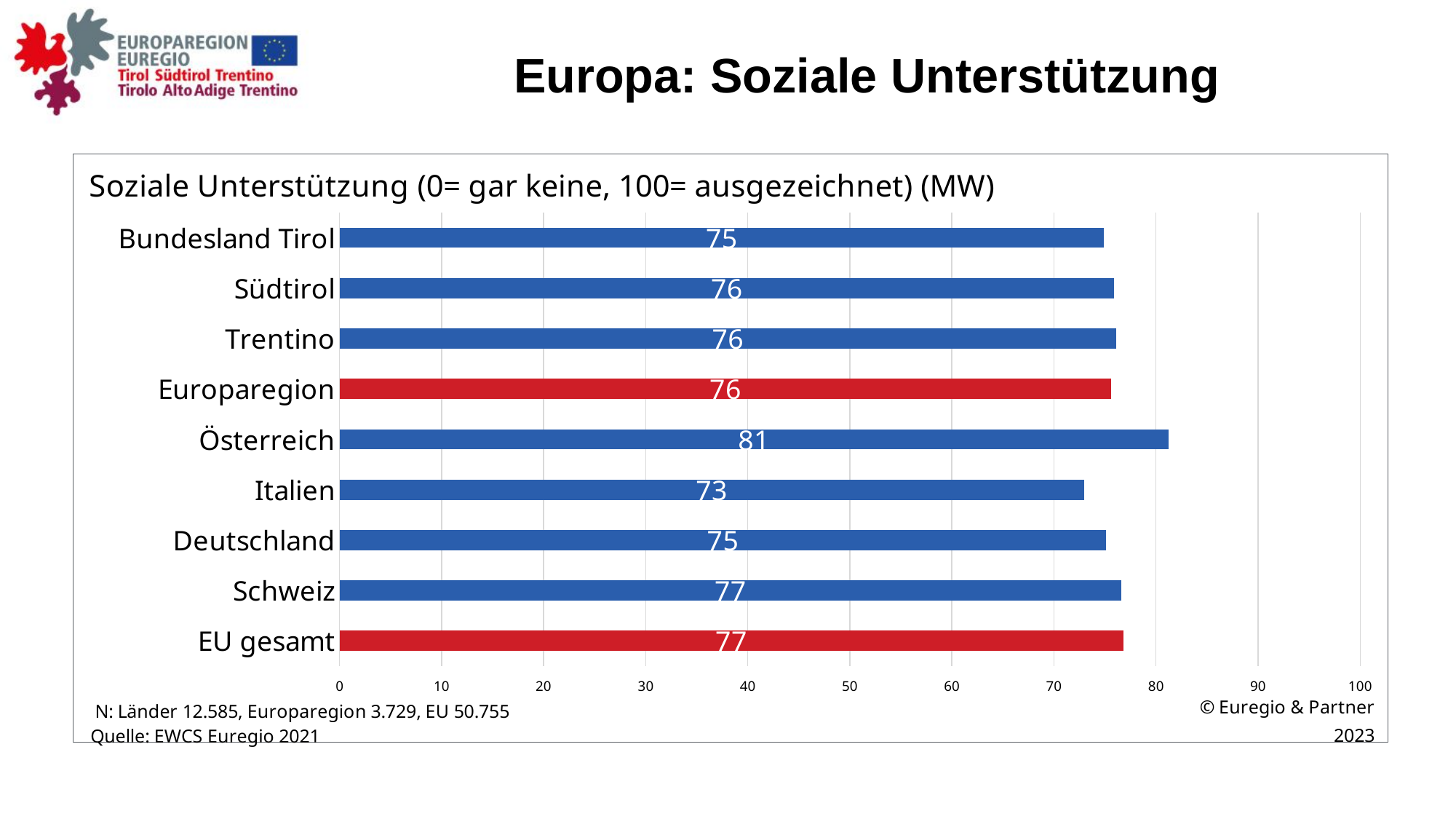
What is the value for Österreich? 81 What is the value for Bundesland Tirol? 75 How many categories are shown in the chart? 9 Which category has the highest value? Österreich Which has a larger value, Österreich or Deutschland? Österreich Which two categories are shown with red bars? Europaregion and EU gesamt What is the difference between the values for Österreich and Italien? 8 What kind of chart is shown on the slide? Bar chart What is the value for Italien? 73 Which category has the lowest value? Italien What is the value for EU gesamt? 77 What is the difference between the values for Schweiz and Deutschland? 2